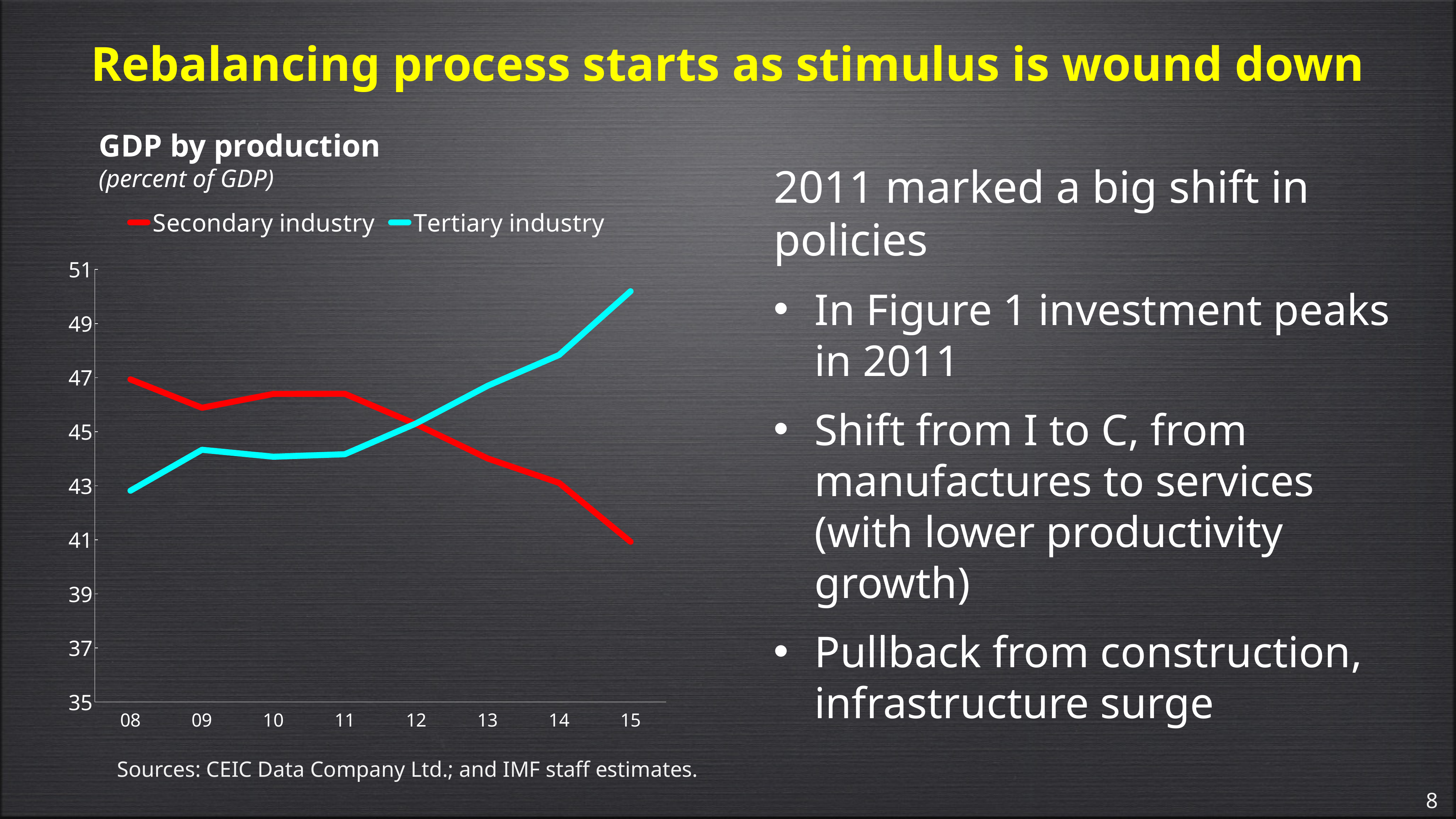
What kind of chart is shown on the slide? line chart In which year is the Tertiary industry share highest? 15 How many series does the legend list? 2 In 15, which series has the larger value, Secondary industry or Tertiary industry? Tertiary industry What colour is the Tertiary industry line? cyan Does the Secondary industry line rise or fall from 11 to 15? fall Is the value for Secondary industry in 15 greater or less than 43? less Is the value for Tertiary industry in 15 greater or less than 49? greater How many years are plotted along the x axis? 8 Does the Tertiary industry line rise or fall from 08 to 15? rise In which year is the Secondary industry share lowest? 15 In 08, which series has the larger value, Secondary industry or Tertiary industry? Secondary industry